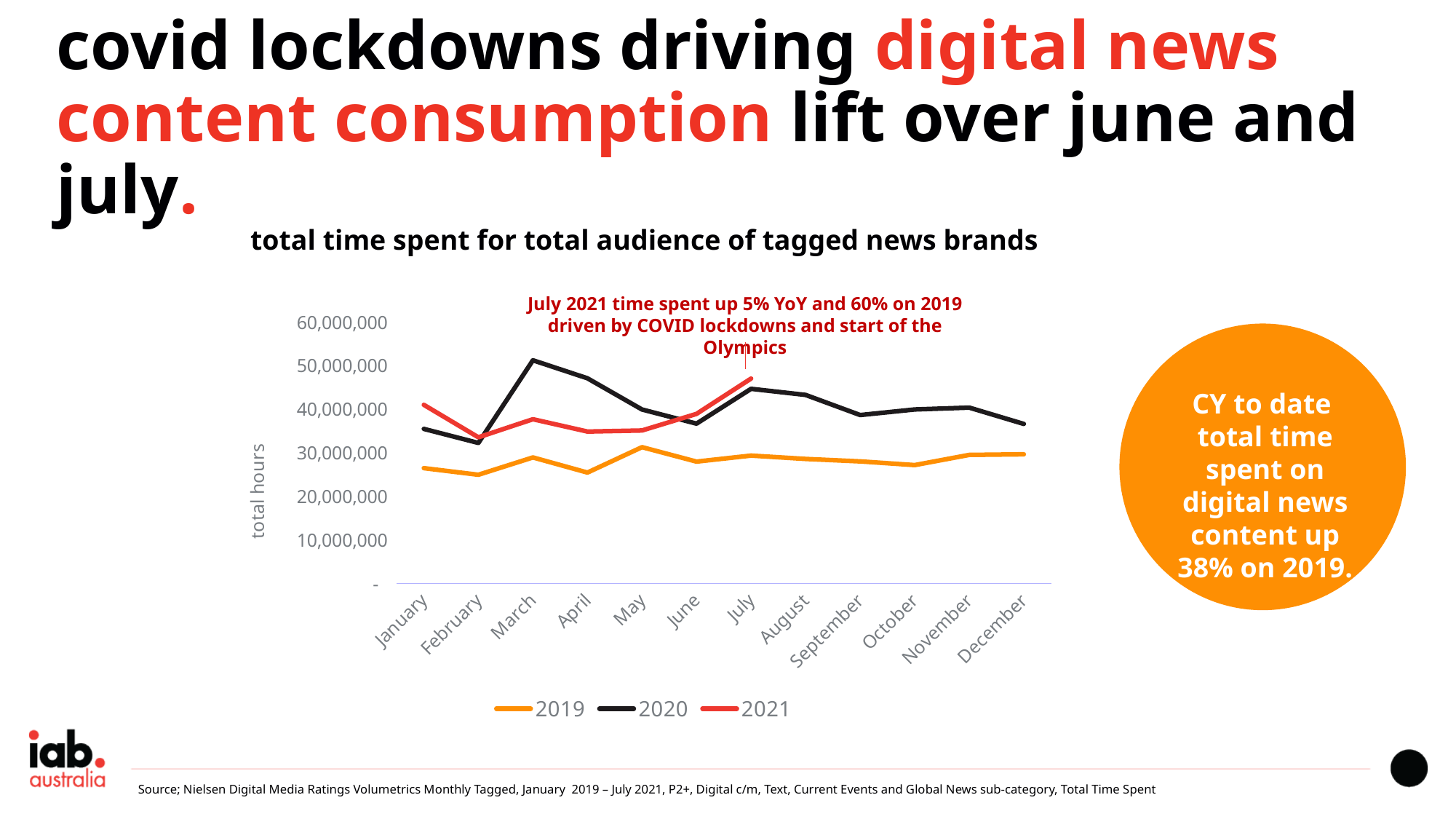
Is the value for 2020 in March greater or less than 40,000,000? greater In which month is the 2020 series at its lowest? February What kind of chart is shown on the slide? line chart Is the value for 2021 in July greater or less than 40,000,000? greater How many months are shown along the x axis? 12 In which month does the 2021 series reach its highest value? July How many series does the legend list? 3 In which month does the 2020 series reach its highest value? March What is the label on the y axis of the chart? total hours Is the value for 2019 in January greater or less than 30,000,000? less In March, which series has the larger value, 2020 or 2021? 2020 In January, which series has the larger value, 2021 or 2019? 2021